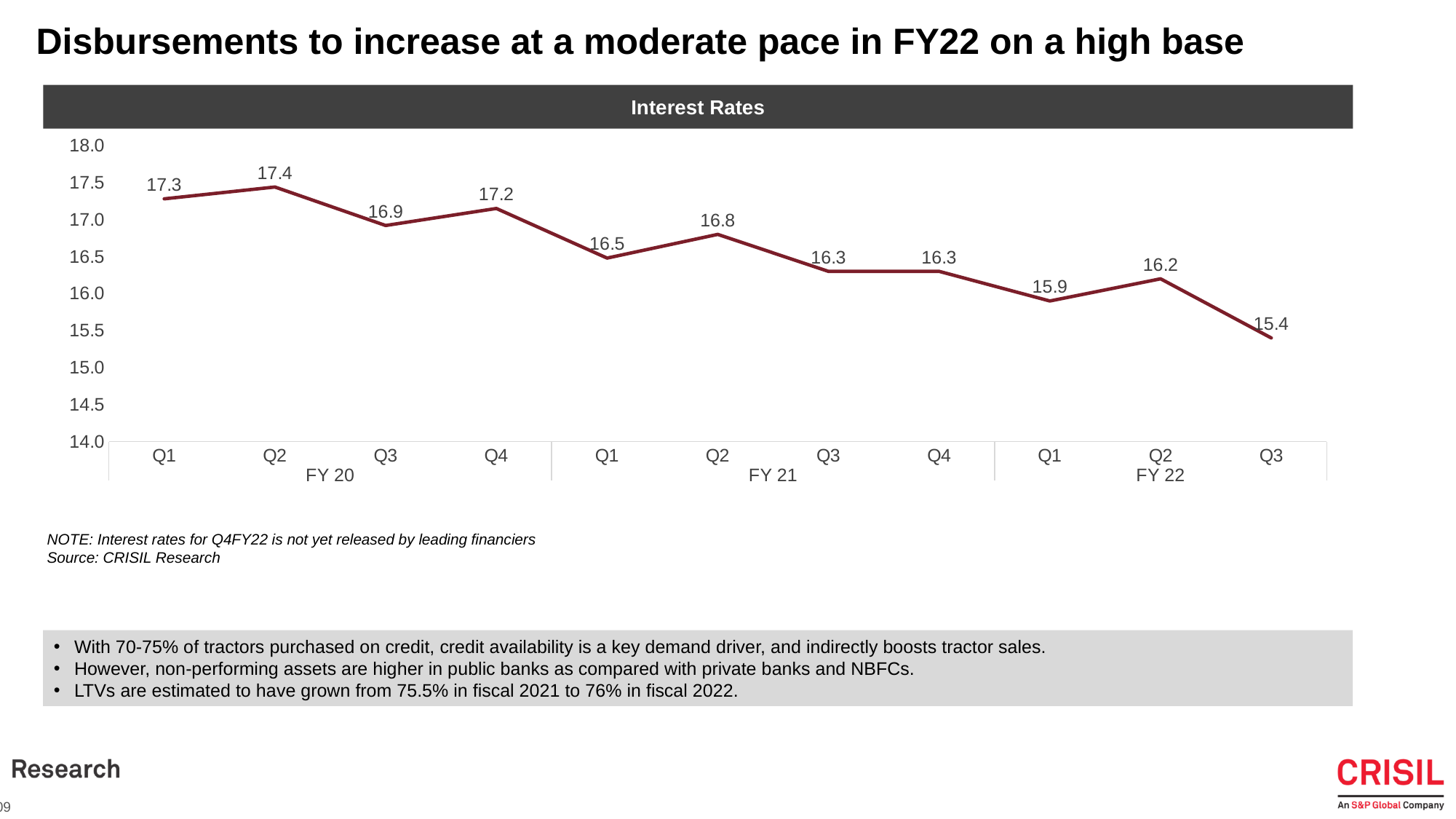
Do interest rates generally rise or fall from Q1 FY 20 to Q3 FY 22? Fall What is the interest rate for Q2 FY 21? 16.8 Which quarter has the lowest interest rate? Q3 FY 22 What is the interest rate for Q1 FY 20? 17.3 What is the title of the chart? Interest Rates How many quarters are plotted on the chart? 11 What is the difference between the interest rate in Q2 FY 20 and Q3 FY 22? 2.0 What type of chart is shown? Line chart Which quarter has the highest interest rate? Q2 FY 20 What is the interest rate for Q3 FY 22? 15.4 Is the interest rate for Q1 FY 22 greater or less than 16.0? less Which is higher, the interest rate in Q4 FY 20 or Q1 FY 21? Q4 FY 20